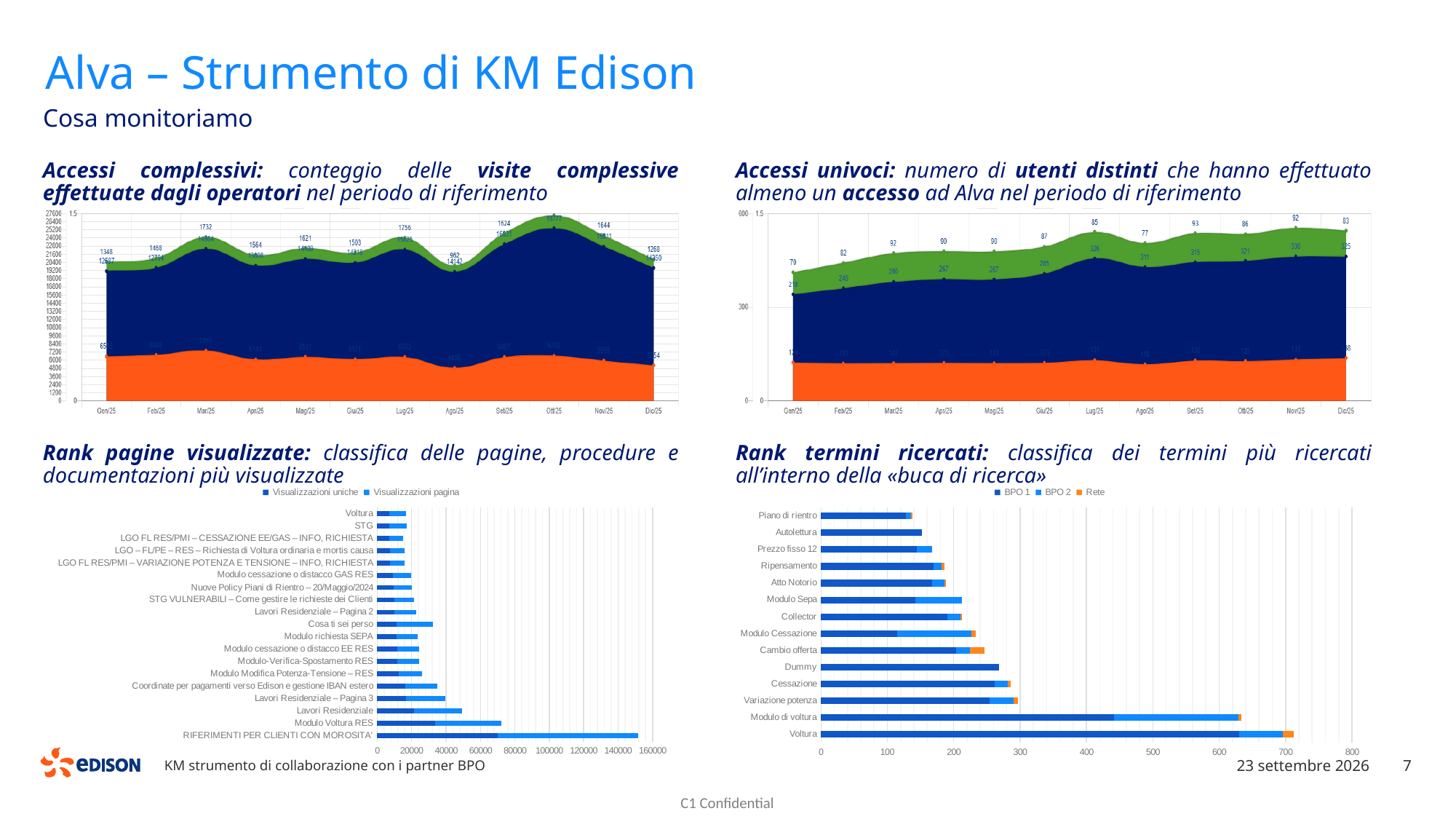
How many series does the legend of the 'Rank pagine visualizzate' chart list? 2 In the 'Accessi univoci' chart, what is the green series value for Set/25? 93 How many series does the legend of the 'Rank termini ricercati' chart list? 3 In the 'Rank termini ricercati' chart, which term has the shortest bar? Piano di rientro In the 'Rank termini ricercati' chart, is the total bar for 'Dummy' greater or less than 300? less In the 'Rank pagine visualizzate' chart, which page has the longest bar? RIFERIMENTI PER CLIENTI CON MOROSITA' In the 'Rank termini ricercati' chart, which term has the longest bar? Voltura In the 'Rank termini ricercati' chart, is the total bar for 'Modulo di voltura' greater or less than 600? greater What kind of chart is the 'Rank termini ricercati' chart at the bottom right? bar chart In the 'Accessi complessivi' chart, what is the green series value for Ago/25? 962 In the 'Accessi univoci' chart, which month has the lowest green series value? Gen/25 How many search terms are listed in the 'Rank termini ricercati' chart? 14